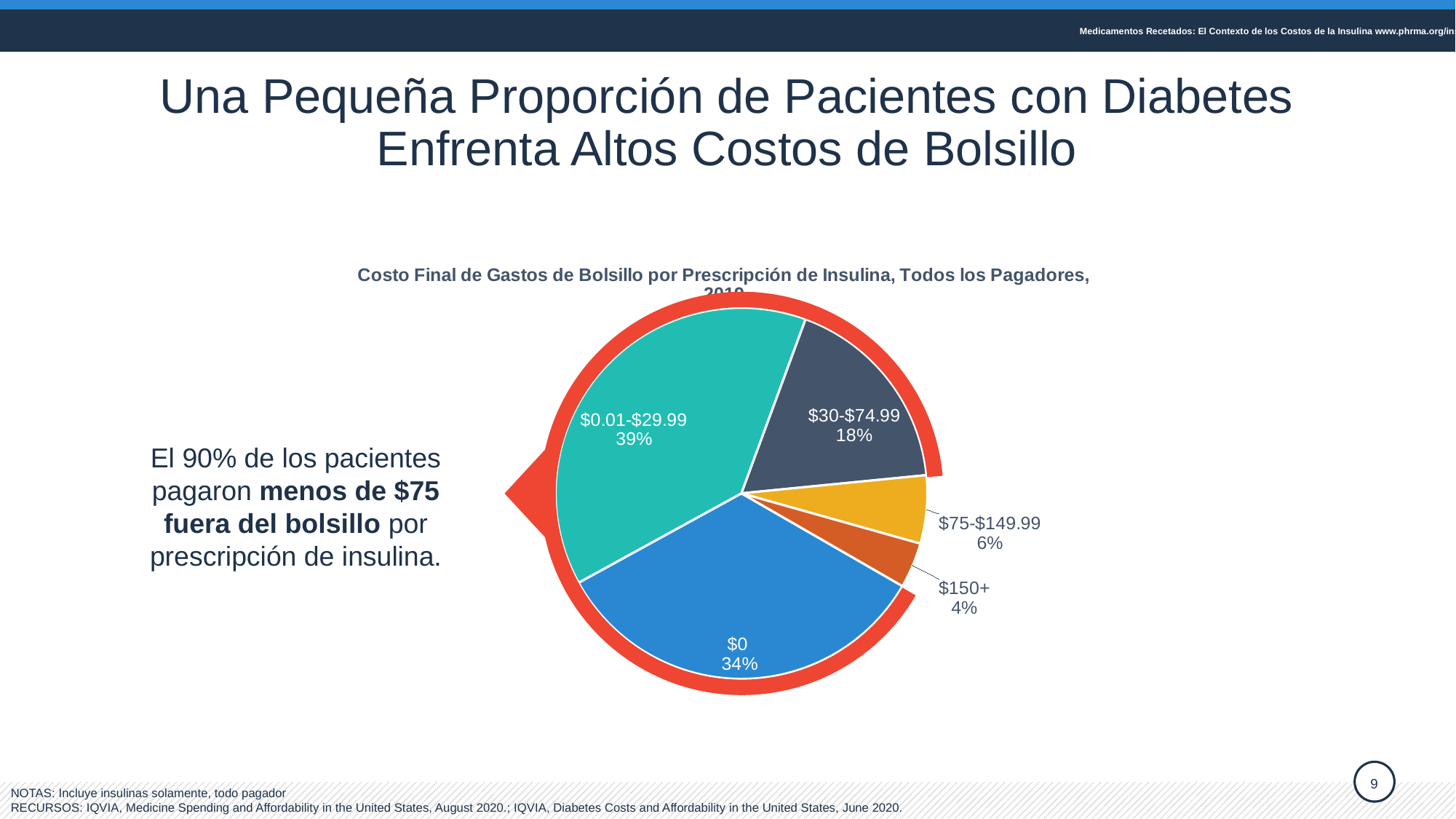
What is the value shown for the $150+ slice? 4% What kind of chart is shown on the slide? Pie chart What is the value shown for the $30-$74.99 slice? 18% Which is larger, the $30-$74.99 slice or the $75-$149.99 slice? $30-$74.99 How many slices does the pie chart have? 5 What is the combined share of the $0, $0.01-$29.99 and $30-$74.99 slices? 91% Which category has the smallest share of the pie? $150+ What is the difference in percentage points between the $0.01-$29.99 slice and the $0 slice? 5 percentage points What is the value shown for the $0 slice? 34% What share of the pie does the $0.01-$29.99 slice represent? 39% What is the value shown for the $75-$149.99 slice? 6% Which category has the largest share of the pie? $0.01-$29.99